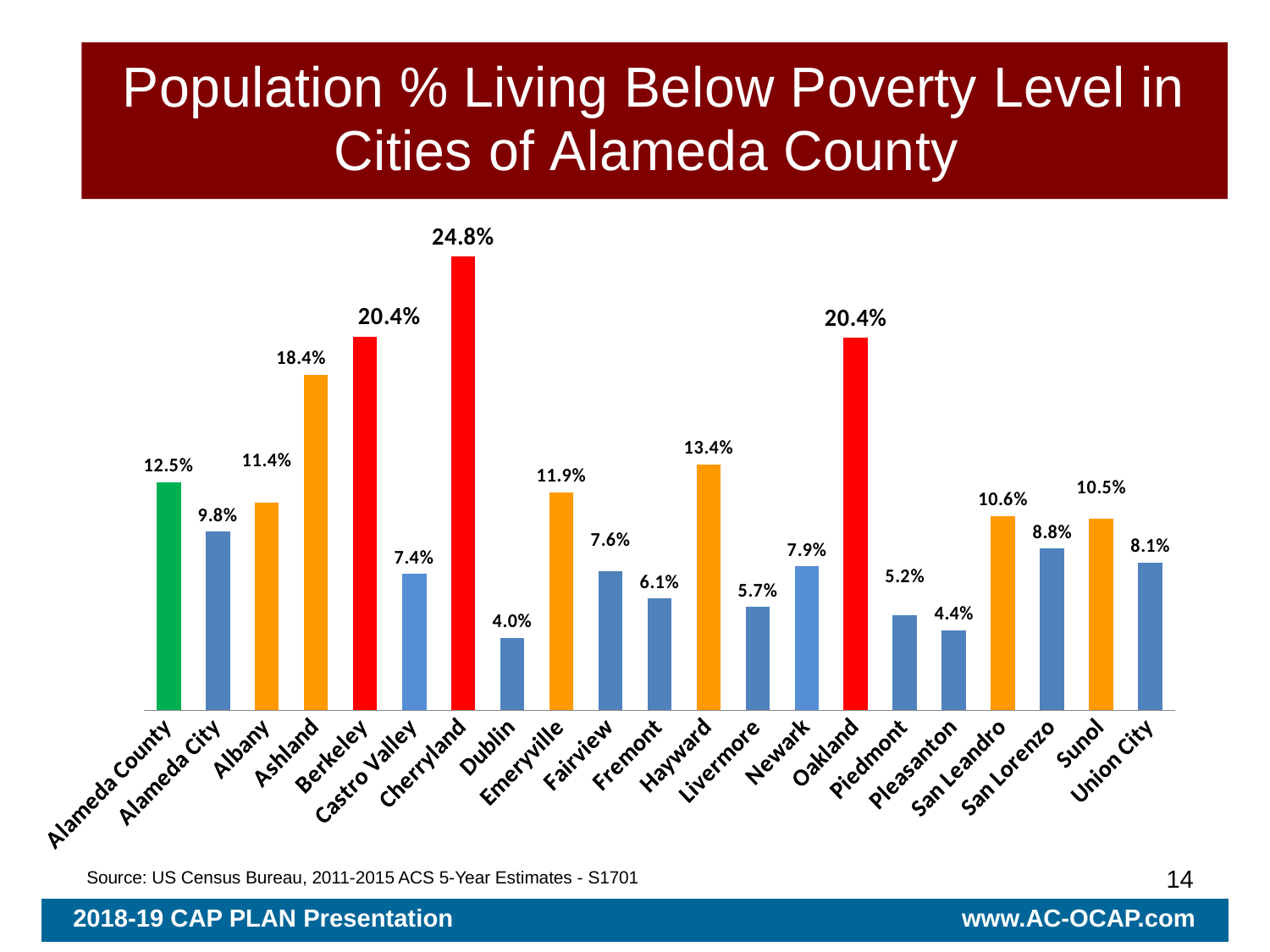
What is the difference in percentage points between Ashland and Albany? 7.0 What is the value shown for Pleasanton? 4.4% Which city has the highest percentage of population living below the poverty level? Cherryland What percentage is shown for Hayward? 13.4% How many categories are plotted on the chart? 21 What is the percentage of the population living below the poverty level in Cherryland? 24.8% What is the difference in percentage points between Cherryland and Dublin? 20.8 Which city has the lowest percentage of population living below the poverty level? Dublin What is the value shown for Alameda County? 12.5% Which has a higher poverty percentage, Emeryville or San Leandro? Emeryville What kind of chart is shown on the slide? Bar chart Which has a higher poverty percentage, Fremont or Newark? Newark